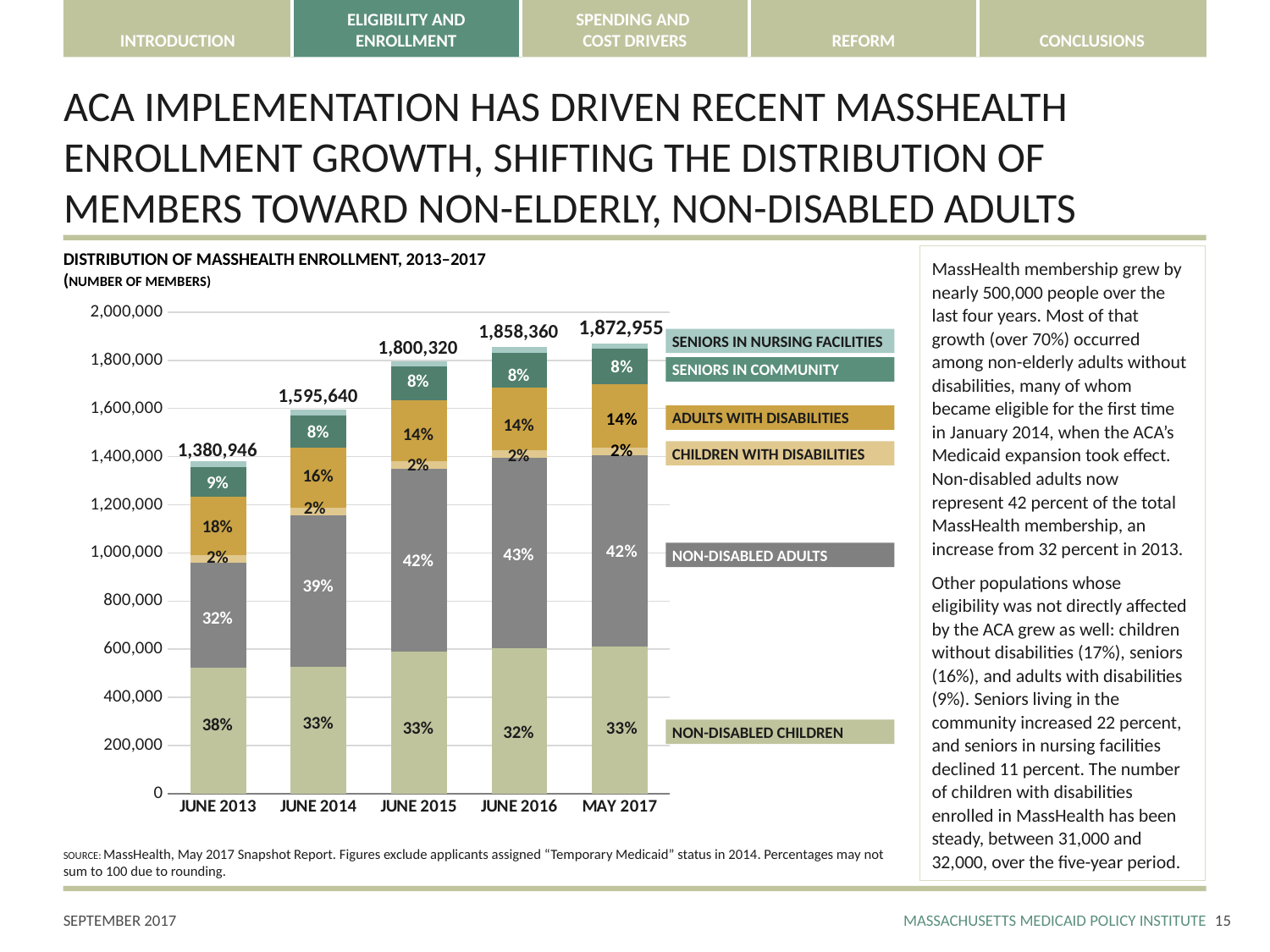
How many time periods (bars) are shown in the chart? 5 How many member categories does the legend list? 6 Which period has the lowest total enrollment? June 2013 What is the total MassHealth enrollment shown for June 2013? 1,380,946 What is the total MassHealth enrollment shown for May 2017? 1,872,955 What kind of chart is used to show the distribution of MassHealth enrollment? Stacked bar chart Does total enrollment rise or fall from June 2013 to May 2017? Rise What is the difference between the total enrollment in May 2017 and in June 2013? 492,009 What percentage of members were adults with disabilities in June 2014? 16% Which period has the highest total enrollment? May 2017 What percentage of members were non-disabled adults in June 2013? 32% What percentage of members were non-disabled children in June 2013? 38%